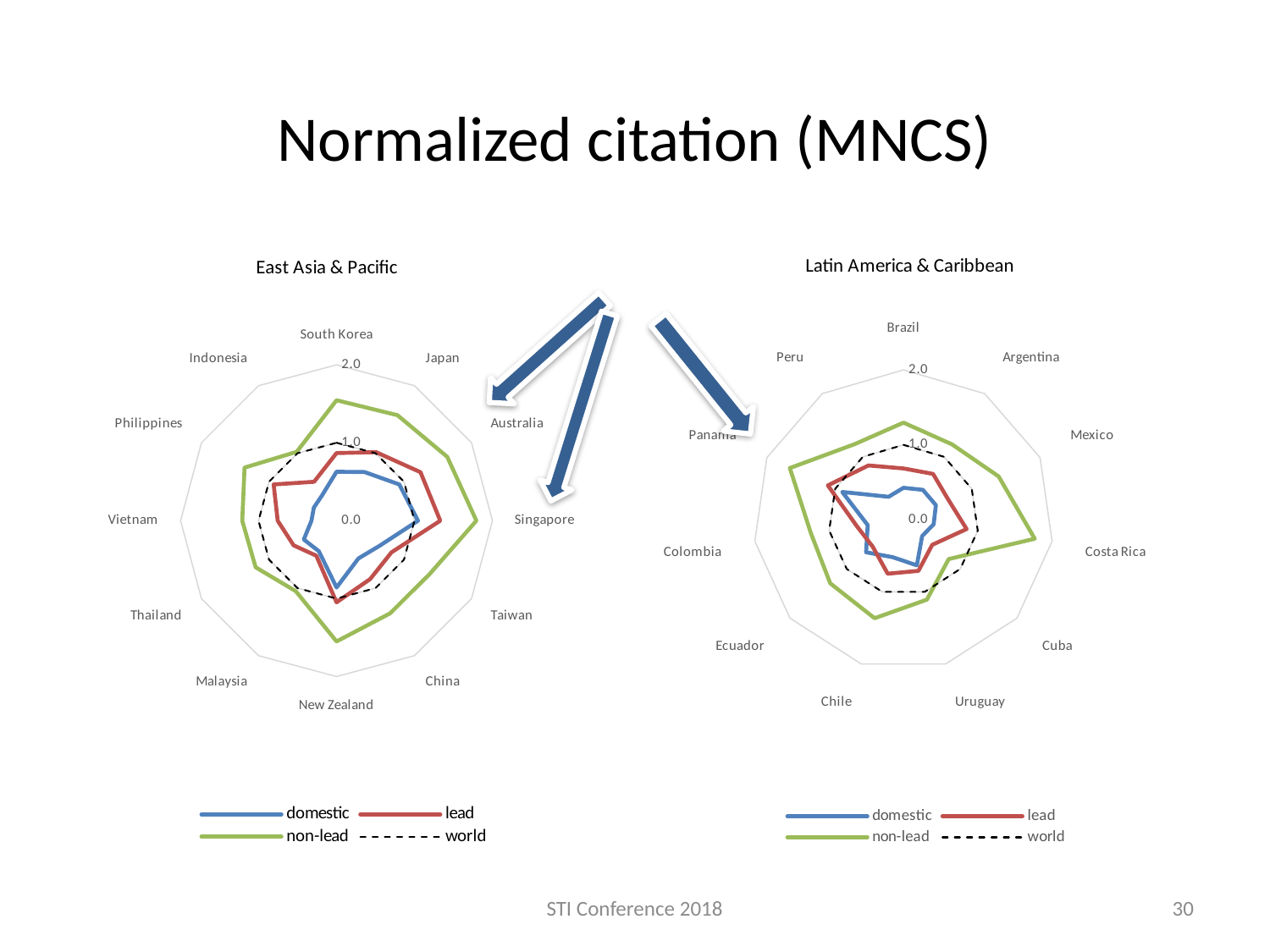
On the East Asia & Pacific chart, is the domestic value for Vietnam greater or less than 1.0? less How many countries are plotted on the Latin America & Caribbean chart? 11 On the Latin America & Caribbean chart, which is larger for Costa Rica, the non-lead value or the domestic value? non-lead On the Latin America & Caribbean chart, is the domestic value for Colombia greater or less than 1.0? less How many countries are plotted on the East Asia & Pacific chart? 12 On the East Asia & Pacific chart, is the non-lead value for Singapore greater or less than 1.0? greater Which series is drawn with a dashed line on the East Asia & Pacific chart? world How many series does the legend of the Latin America & Caribbean chart list? 4 What is the title of the chart on the right side of the slide? Latin America & Caribbean What kind of chart is the East Asia & Pacific chart? radar chart